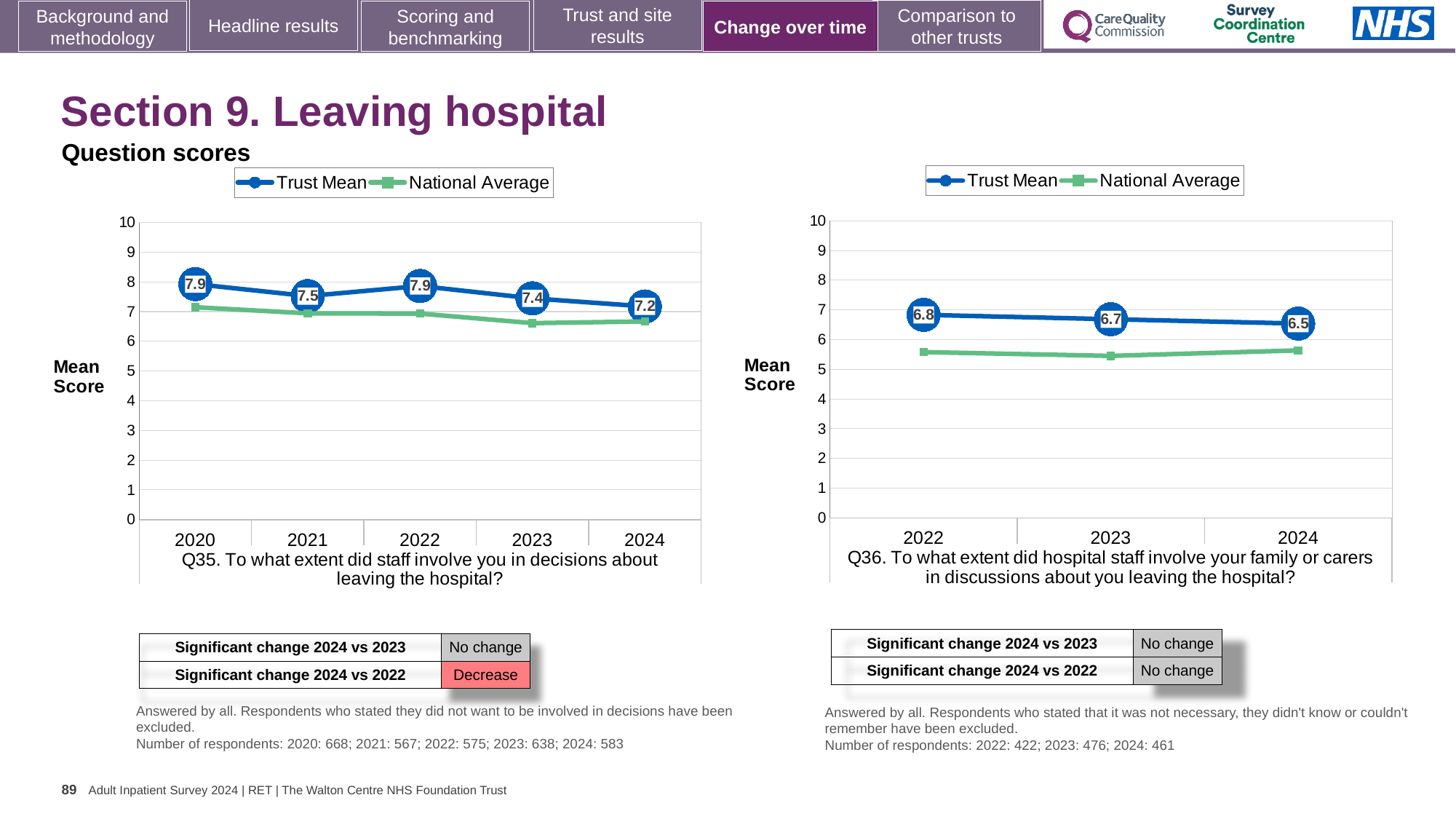
How many years are plotted on the x axis of the Q36 chart on the right? 3 How many series does the legend of the Q35 chart on the left list? 2 In the Q36 chart on the right, does the Trust Mean score rise or fall from 2022 to 2024? fall In the Q35 chart on the left, which year has the lowest Trust Mean score? 2024 In the Q35 chart on the left, is the Trust Mean score higher in 2021 or in 2023? 2021 In the Q35 chart on the left, what is the difference between the Trust Mean scores for 2020 and 2024? 0.7 In the Q36 chart on the right, is the National Average value for 2023 greater or less than 6? less In the Q35 chart on the left, is the National Average value for 2023 greater or less than 7? less In the Q36 chart on the right, what is the Trust Mean score for 2022? 6.8 In the Q35 chart on the left, what is the Trust Mean score for 2024? 7.2 In the Q36 chart on the right, which year has the highest Trust Mean score? 2022 In the Q36 chart on the right, what is the difference between the Trust Mean scores for 2022 and 2024? 0.3